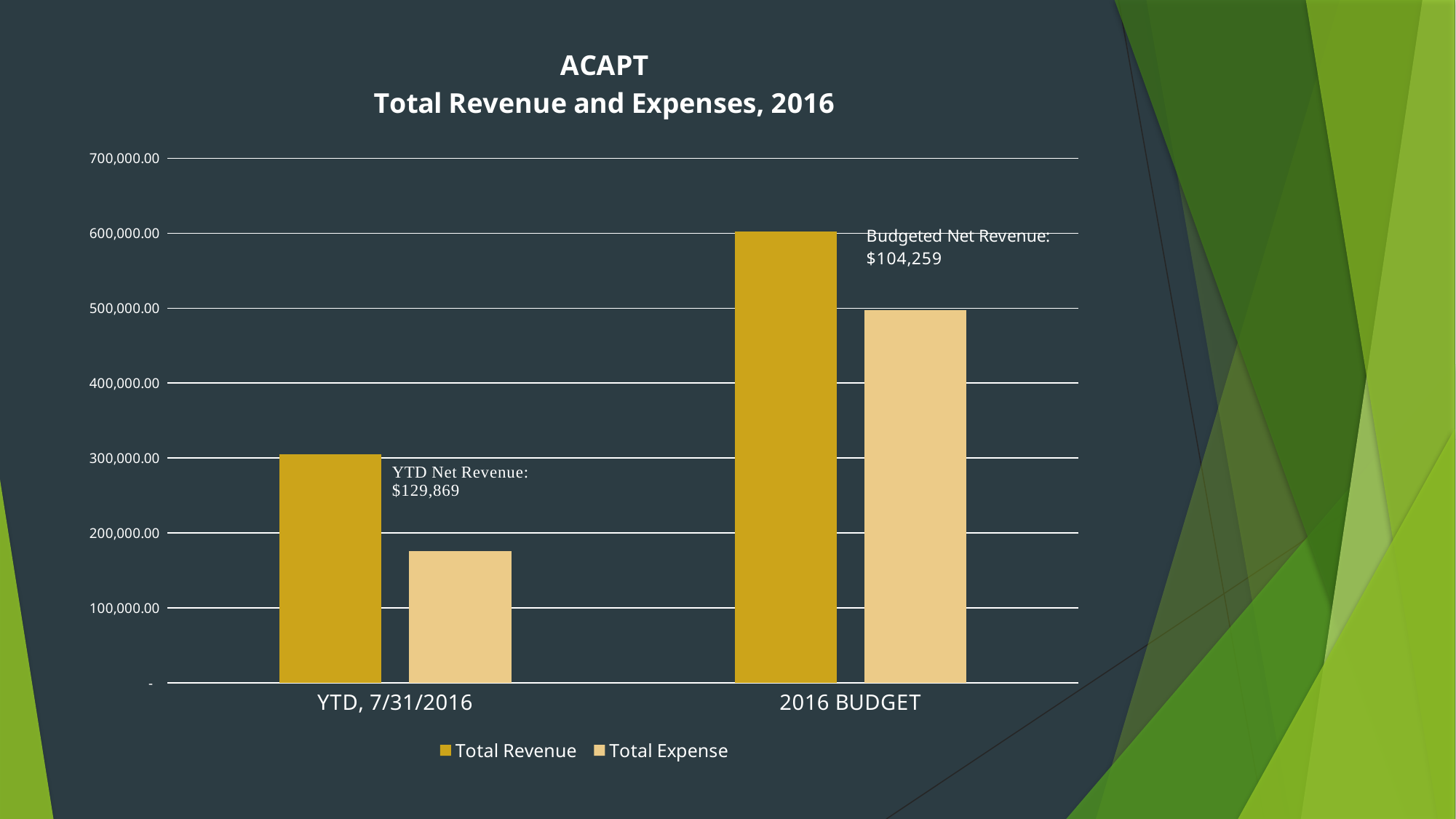
What is the title of the chart? ACAPT Total Revenue and Expenses, 2016 How many series does the legend list? 2 What kind of chart is shown on the slide? bar chart What is the Budgeted Net Revenue stated on the chart? $104,259 Which bar is the lowest on the chart? Total Expense for YTD, 7/31/2016 Which category has the higher Total Revenue bar? 2016 BUDGET Is the Total Expense for YTD, 7/31/2016 greater or less than 200,000.00? less For YTD, 7/31/2016, which is larger: Total Revenue or Total Expense? Total Revenue Is the Total Expense for 2016 BUDGET greater or less than 600,000.00? less What is the YTD Net Revenue stated on the chart? $129,869 How many categories are shown on the x axis? 2 Is the Total Revenue for 2016 BUDGET greater or less than 500,000.00? greater